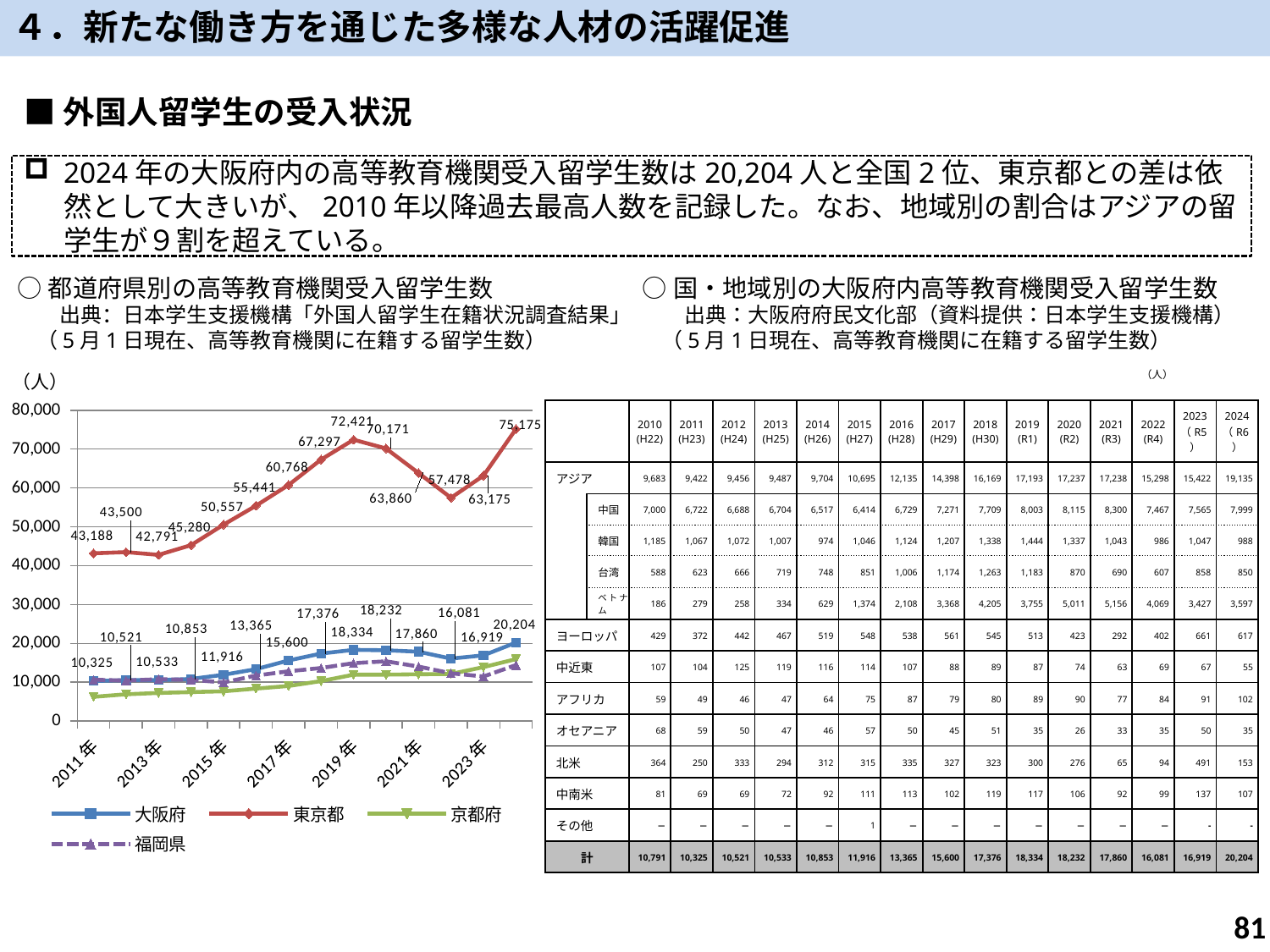
In the line chart, what is the difference between the final labelled values of 東京都 (75,175) and 大阪府 (20,204)? 54,971 In the line chart, what is the highest value labelled for 東京都? 75,175 In the line chart, what is the lowest value labelled for 大阪府? 10,325 In the line chart, does the 東京都 series overall rise or fall from 2011年 to the last point? rise In the line chart, what is the lowest value labelled for 東京都? 42,791 What unit is shown at the top of the y axis of the line chart? （人） In the line chart, is the value for 京都府 at 2011年 greater or less than 10,000? less In the line chart, which series has higher values throughout, 東京都 or 大阪府? 東京都 How many series does the legend of the line chart list? 4 Which series in the line chart is drawn with a dashed line? 福岡県 In the line chart, what is the highest value labelled for 大阪府? 20,204 What kind of chart is shown on the left of the slide? line chart